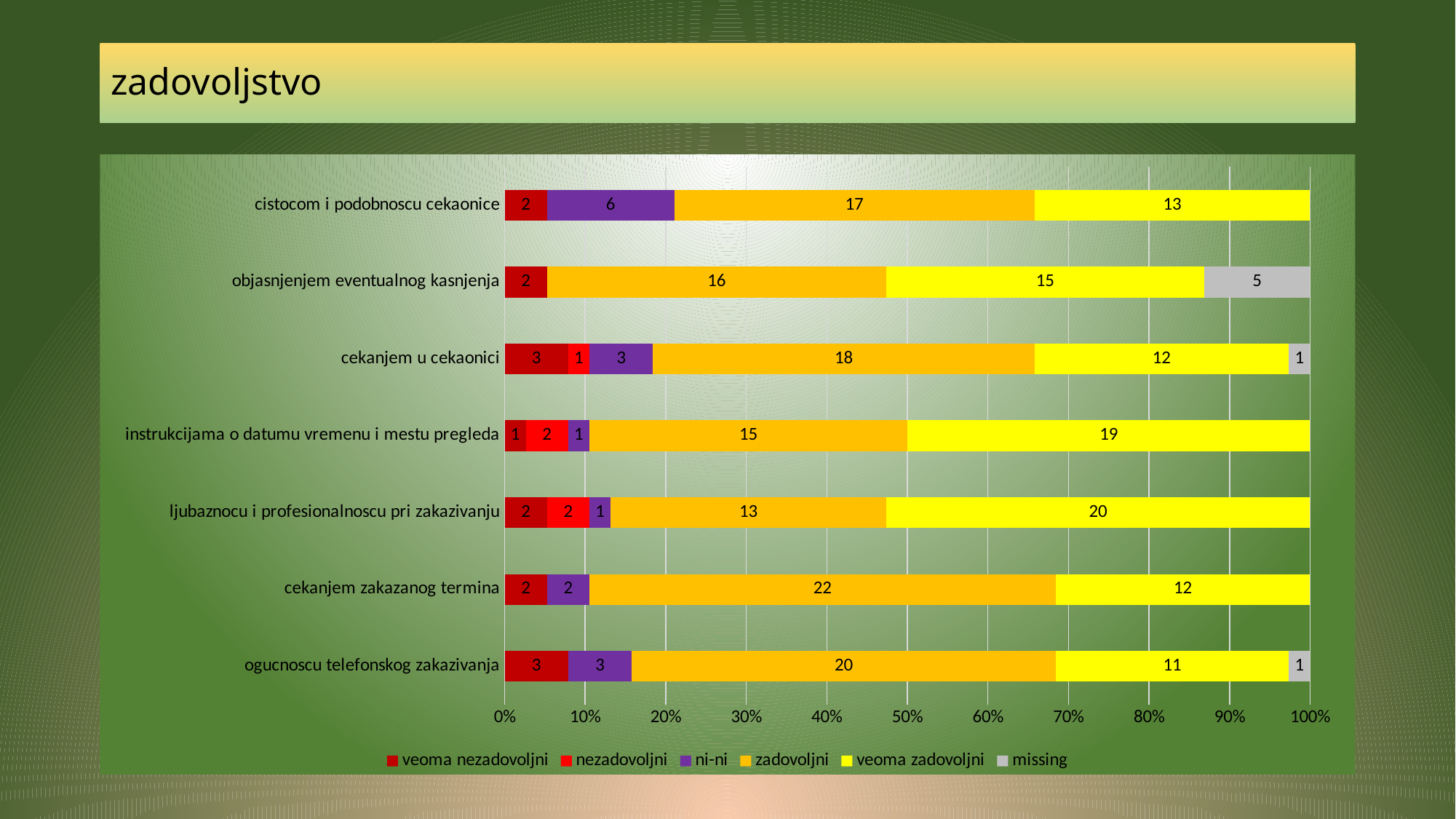
What kind of chart is shown on the slide? stacked bar chart Which is larger: the 'zadovoljni' value for 'cekanjem u cekaonici' or for 'objasnjenjem eventualnog kasnjenja'? cekanjem u cekaonici What is the 'missing' value for 'objasnjenjem eventualnog kasnjenja'? 5 What is the 'ni-ni' value for 'cistocom i podobnoscu cekaonice'? 6 What is the 'zadovoljni' value for 'cekanjem zakazanog termina'? 22 What is the difference between the 'veoma zadovoljni' values for 'instrukcijama o datumu vremenu i mestu pregleda' and 'cekanjem u cekaonici'? 7 Which category has the highest 'zadovoljni' value? cekanjem zakazanog termina Which category has the lowest 'veoma zadovoljni' value? ogucnoscu telefonskog zakazivanja How many categories are shown on the chart? 7 What is the total of all segments in the bar for 'cekanjem u cekaonici'? 38 What is the 'veoma zadovoljni' value for 'ljubaznocu i profesionalnoscu pri zakazivanju'? 20 How many series does the legend list? 6